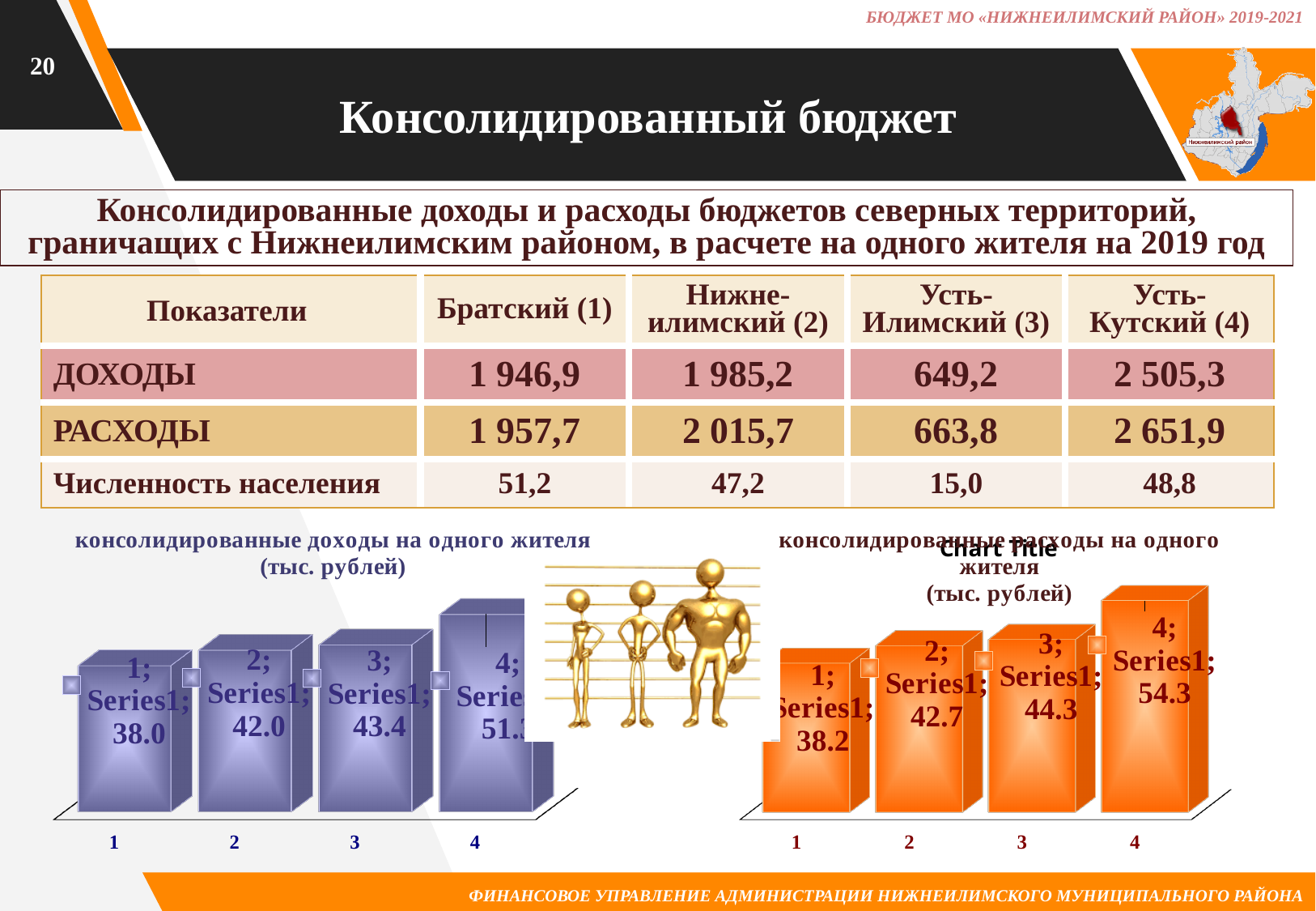
In the right chart (консолидированные расходы на одного жителя), do the values rise or fall from category 1 to category 4? rise In the right chart (консолидированные расходы на одного жителя), what is the value for category 4? 54.3 In the left chart (консолидированные доходы на одного жителя), which category has the lowest value? 1 In the left chart (консолидированные доходы на одного жителя), which category has the highest value? 4 In the left chart (консолидированные доходы на одного жителя), what is the value for category 1? 38.0 In the right chart (консолидированные расходы на одного жителя), how many categories are plotted? 4 In the right chart (консолидированные расходы на одного жителя), what is the value for category 1? 38.2 In the left chart (консолидированные доходы на одного жителя), what is the value for category 2? 42.0 In the left chart (консолидированные доходы на одного жителя), what kind of chart is used? bar chart In the left chart (консолидированные доходы на одного жителя), what is the difference between the values for category 2 and category 1? 4.0 In the left chart (консолидированные доходы на одного жителя), what is the value for category 3? 43.4 In the right chart (консолидированные расходы на одного жителя), what is the difference between the values for category 4 and category 3? 10.0